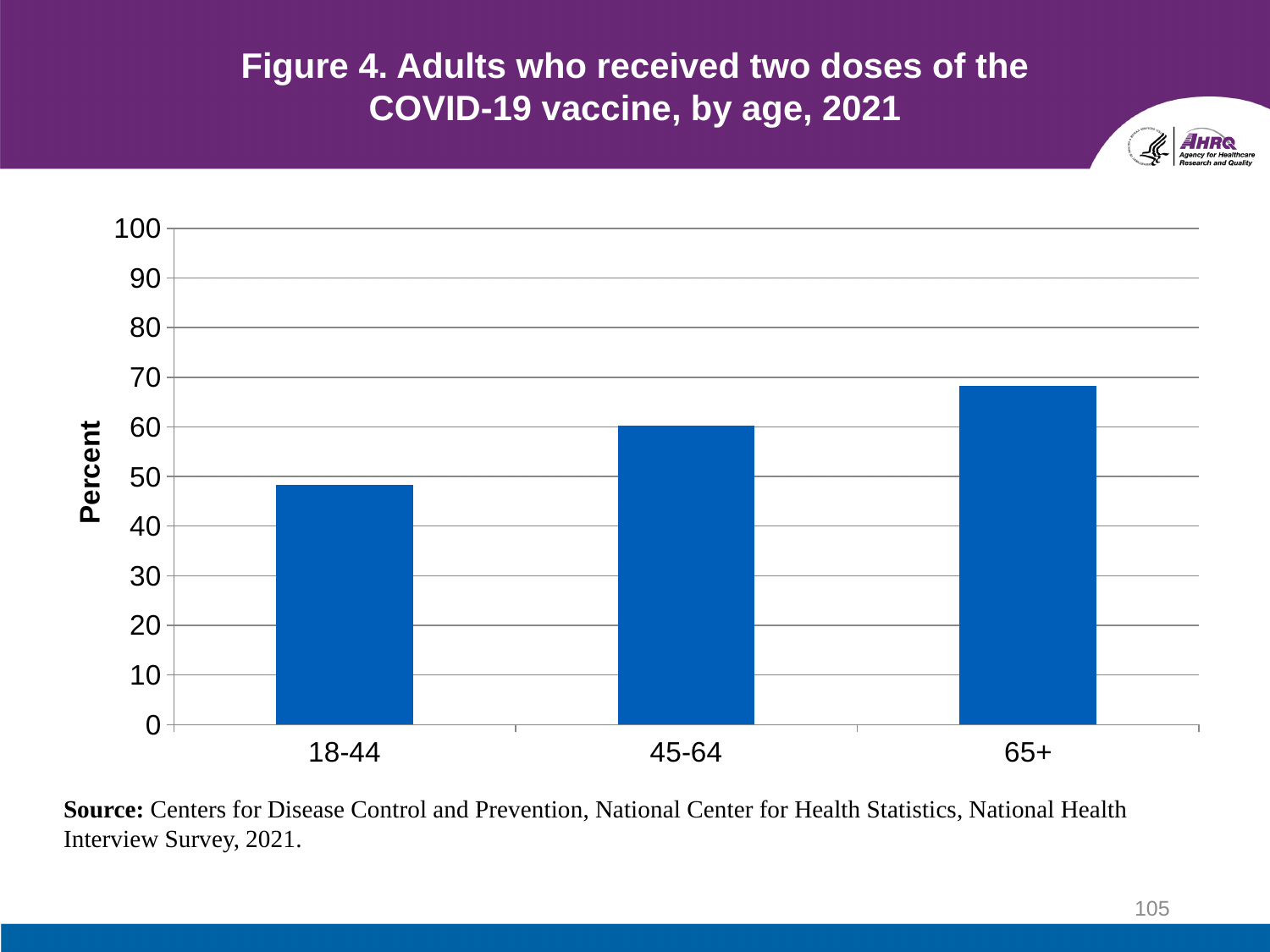
Is the value for the 45-64 age group greater or less than 50? greater What kind of chart is shown on the slide? bar chart What is the label on the y axis of the chart? Percent Which age group has the lowest percentage of adults who received two doses of the COVID-19 vaccine? 18-44 Is the value for the 65+ age group greater or less than 80? less Is the value for the 18-44 age group greater or less than 40? greater Which age group has the highest percentage of adults who received two doses of the COVID-19 vaccine? 65+ Do the values rise or fall as age group increases from 18-44 to 65+? rise Which age group has a higher value, 18-44 or 45-64? 45-64 Which age group has a higher value, 18-44 or 65+? 65+ How many age groups are shown on the x axis of the chart? 3